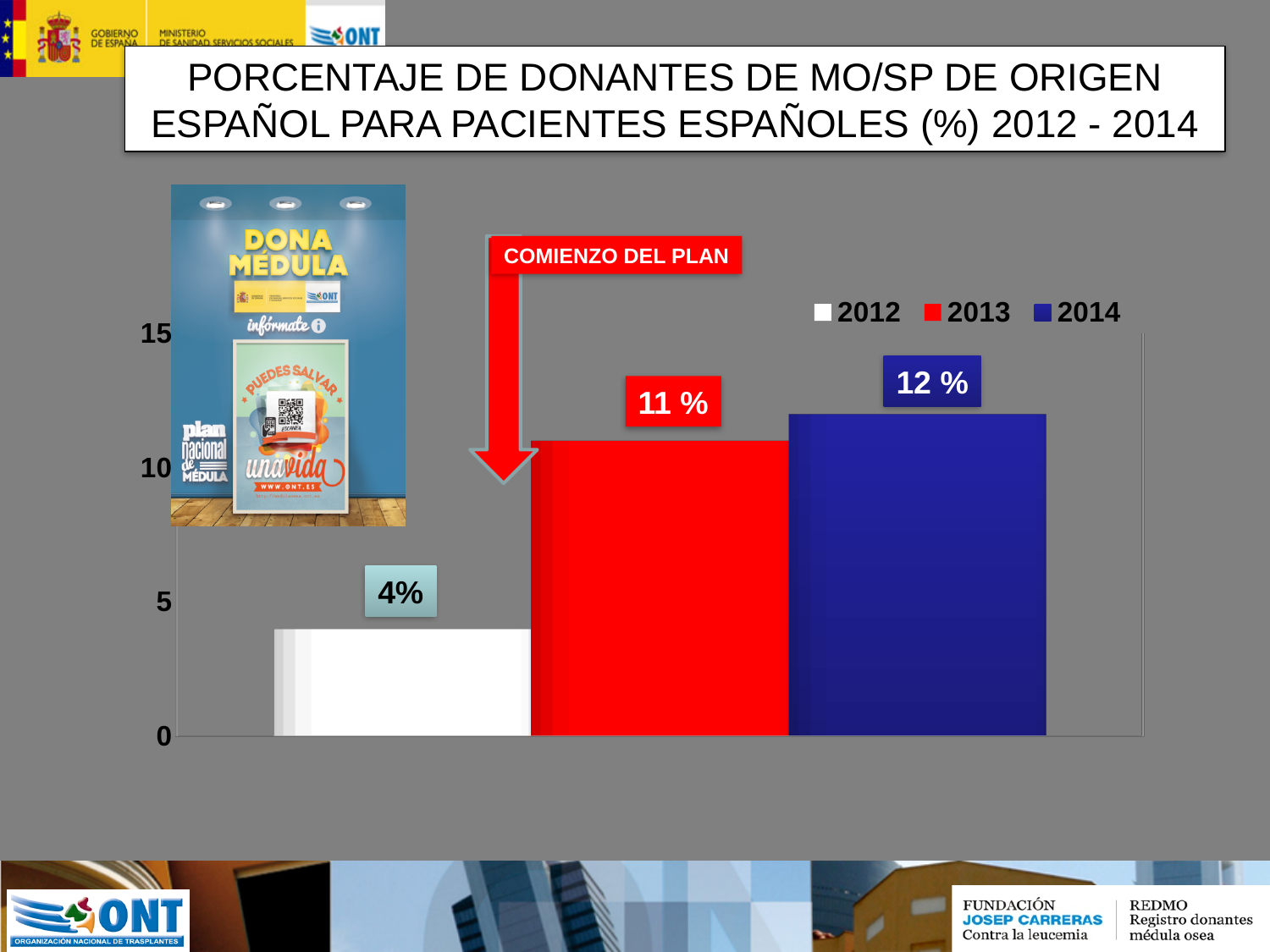
Do the values rise or fall from 2012 to 2014? rise What is the value shown for 2014? 12 % Which year has the lowest percentage? 2012 What is the value shown for 2013? 11 % What does the red annotation box above the chart say? COMIENZO DEL PLAN Which is larger, the value for 2013 or the value for 2014? 2014 What is the value shown for 2012? 4% How many series does the legend list? 3 What kind of chart is shown on the slide? bar chart By how many percentage points did the value increase from 2012 to 2013? 7 percentage points Is the value for 2012 greater or less than 5? less Which year has the highest percentage? 2014